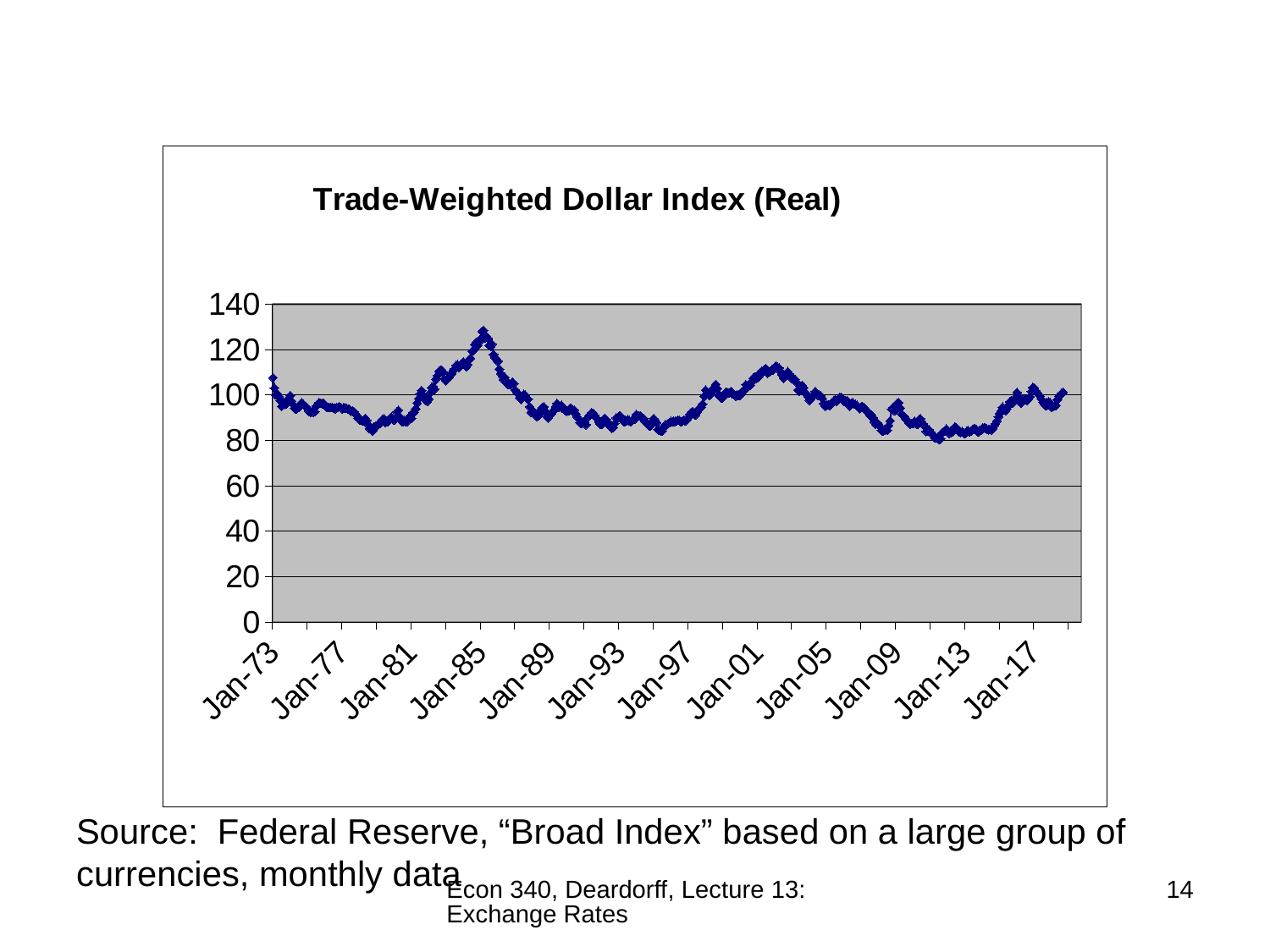
Is the value of the index at Jan-09 greater or less than 100? less Is the value of the index at Jan-13 greater or less than 100? less What is the title of the chart? Trade-Weighted Dollar Index (Real) How many date labels are shown along the x axis? 12 What is the highest value labelled on the vertical axis? 140 Which is larger, the index value at Jan-85 or at Jan-89? Jan-85 Is the value of the index at Jan-73 greater or less than 100? greater Which is larger, the index value at Jan-01 or at Jan-09? Jan-01 What kind of chart is shown on the slide? line chart Around which x-axis label does the index reach its highest peak? Jan-85 Does the index rise or fall between Jan-85 and Jan-89? fall